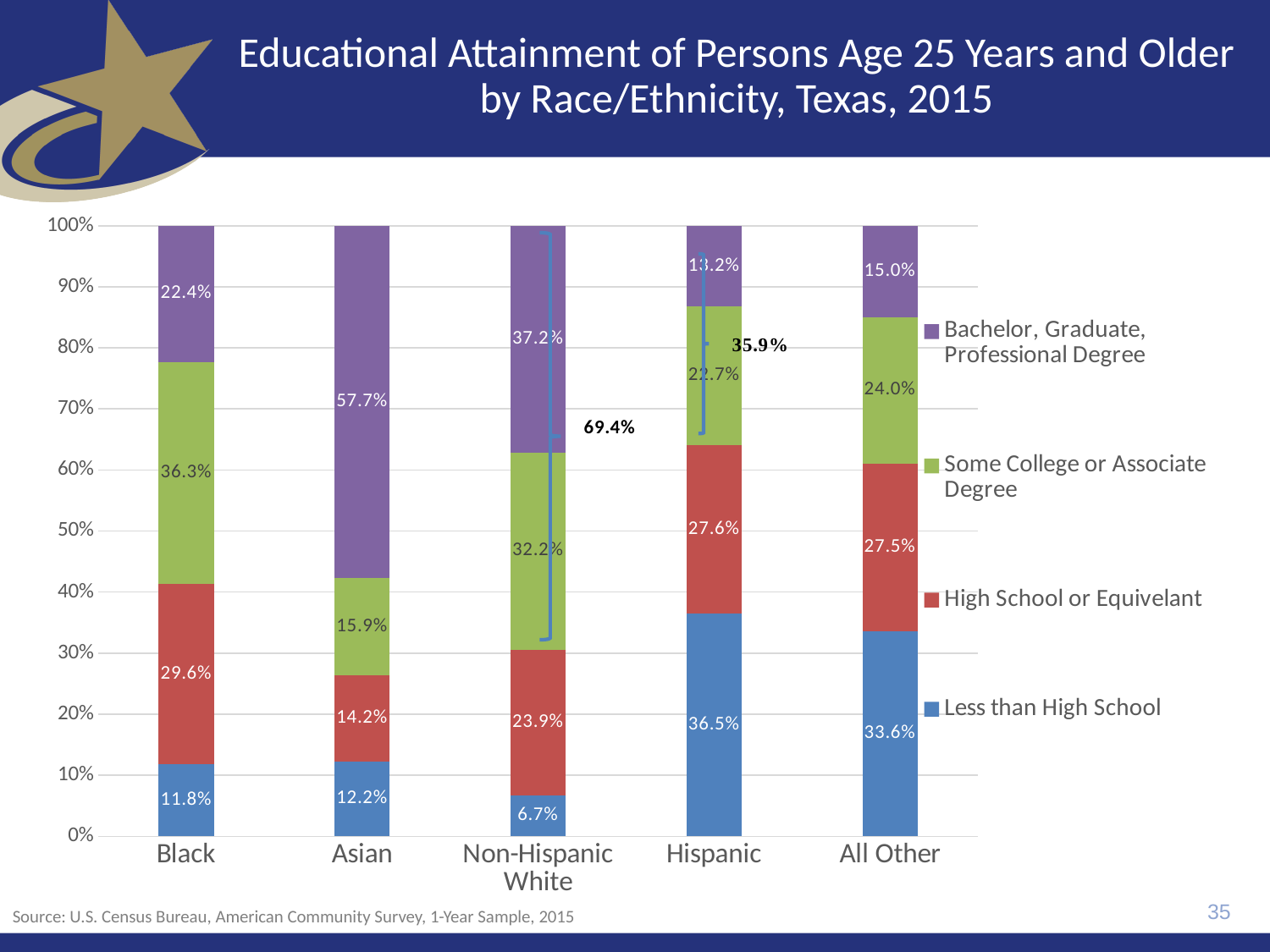
Which race/ethnicity has the highest Less than High School share? Hispanic What is the Less than High School share for Black persons? 11.8% What is the difference between the Bachelor, Graduate, Professional Degree shares for Asian and Black persons? 35.3% How many race/ethnicity categories are shown on the x axis? 5 What is the High School or Equivelant share for Non-Hispanic White persons? 23.9% What is the Bachelor, Graduate, Professional Degree share for Asian persons? 57.7% Which race/ethnicity has the lowest Less than High School share? Non-Hispanic White What is the Some College or Associate Degree share for All Other? 24.0% How many series does the legend list? 4 What kind of chart is shown on the slide? Stacked bar chart Which is larger, the Some College or Associate Degree share for Black persons or for Asian persons? Black What combined percentage is annotated for the top two segments of the Non-Hispanic White bar? 69.4%